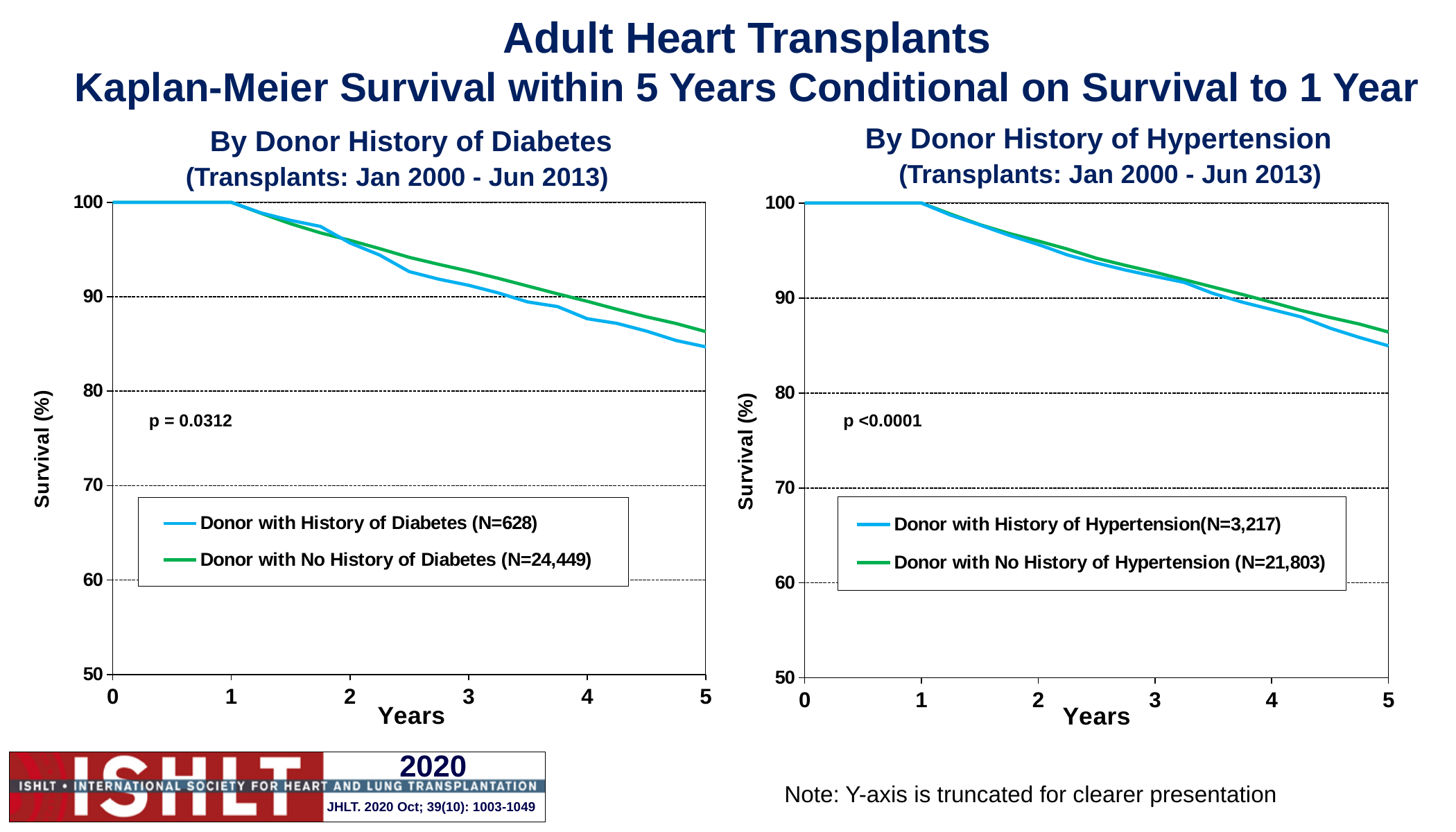
In the right chart, 'By Donor History of Hypertension', which series has the higher survival at year 5? Donor with No History of Hypertension (N=21,803) In the right chart, 'By Donor History of Hypertension', is the survival for Donor with History of Hypertension at year 5 greater or less than 90? less In the left chart, 'By Donor History of Diabetes', which series has the higher survival at year 5? Donor with No History of Diabetes (N=24,449) What kind of chart is the left chart, 'By Donor History of Diabetes'? Line chart In the right chart, 'By Donor History of Hypertension', do the survival curves rise or fall as years increase from 1 to 5? Fall In the left chart, 'By Donor History of Diabetes', is the survival for Donor with History of Diabetes at year 5 greater or less than 90? less What p-value is shown on the left chart, 'By Donor History of Diabetes'? p = 0.0312 In the right chart, 'By Donor History of Hypertension', is the survival for Donor with No History of Hypertension at year 2 greater or less than 90? greater In the left chart, 'By Donor History of Diabetes', what is the survival (%) for Donor with History of Diabetes at year 1? 100 How many series does the legend of the left chart, 'By Donor History of Diabetes', list? 2 How many series does the legend of the right chart, 'By Donor History of Hypertension', list? 2